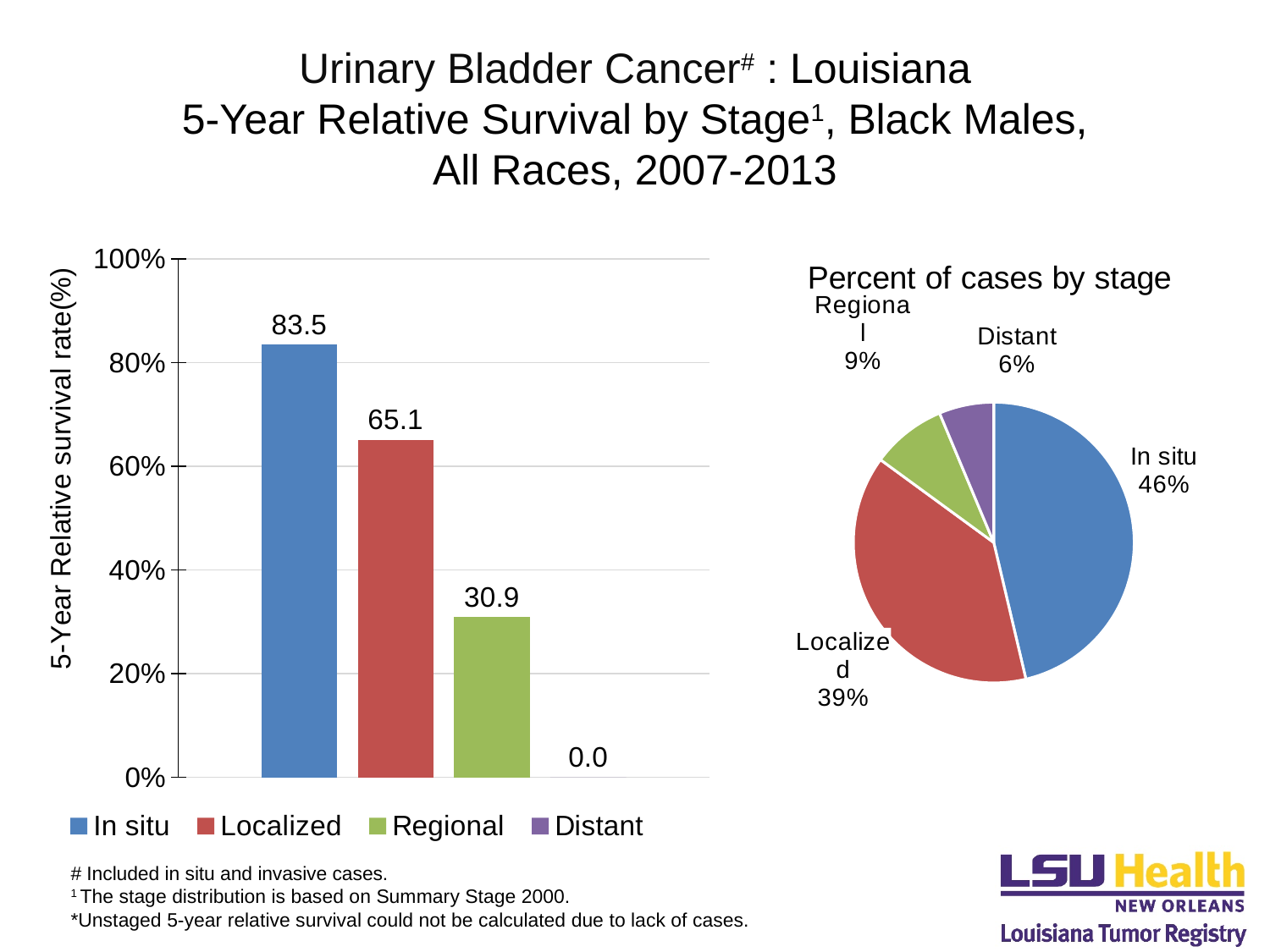
In the 'Percent of cases by stage' pie chart, which stage has the smallest share of cases? Distant In the bar chart, what is the difference between the survival rates for In situ and Localized? 18.4 In the bar chart, which stage has the highest 5-year relative survival rate? In situ In the bar chart, what is the 5-year relative survival rate for Regional? 30.9 How many stages does the legend of the bar chart list? 4 What kind of chart is the chart on the left? bar chart In the bar chart, which has a higher survival rate, Localized or Regional? Localized In the 'Percent of cases by stage' pie chart, what is the difference between the Localized and Regional shares? 30% In the 'Percent of cases by stage' pie chart, what share of cases are In situ? 46% In the bar chart, which stage has the lowest 5-year relative survival rate? Distant In the bar chart, is the value for Localized greater or less than 60%? greater In the bar chart, what is the 5-year relative survival rate for In situ? 83.5